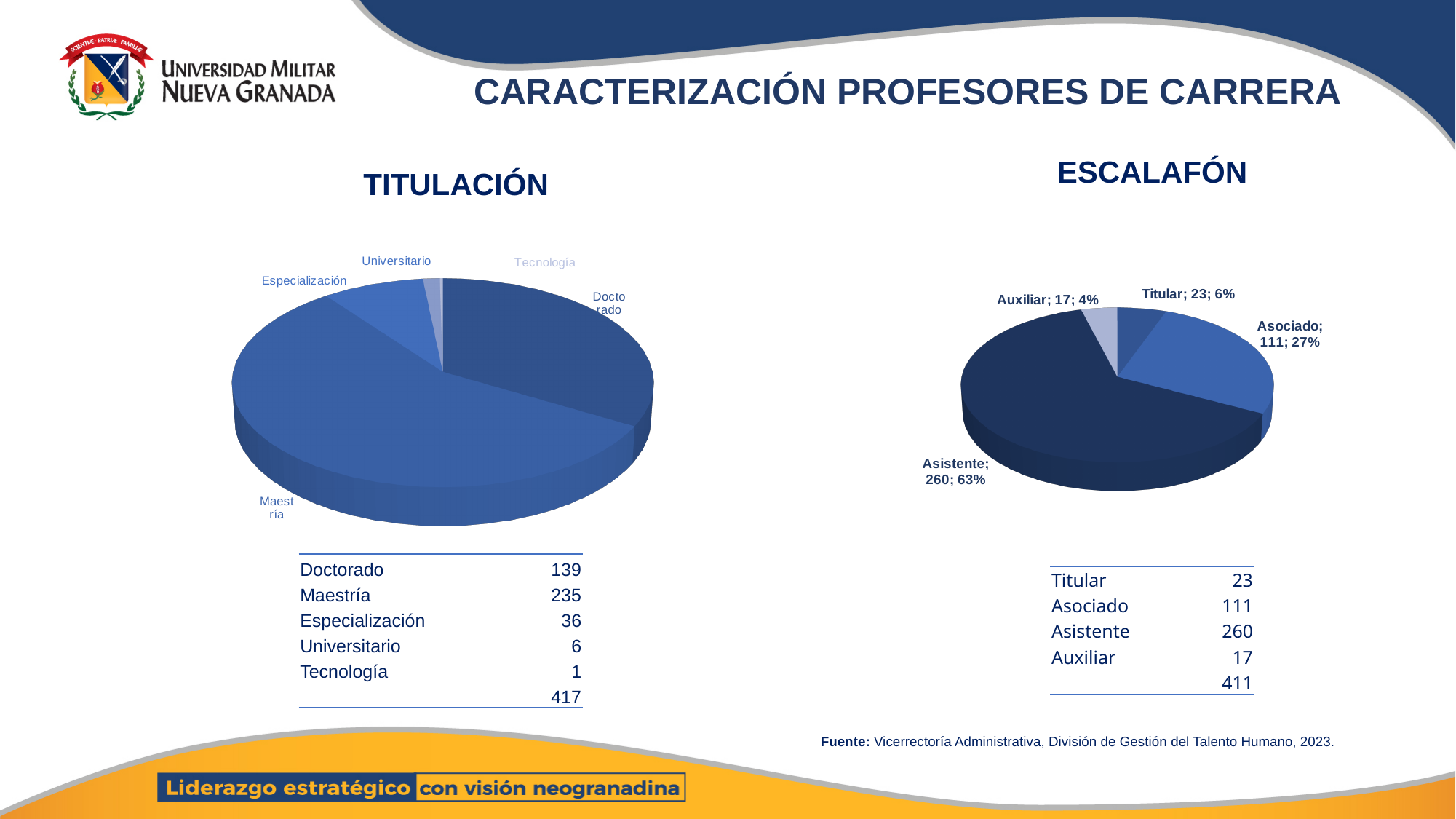
In the ESCALAFÓN chart, which is larger, Titular or Auxiliar? Titular In the TITULACIÓN chart, which category has the largest slice? Maestría What kind of chart is the TITULACIÓN chart? pie chart In the ESCALAFÓN chart, what is the difference between Asistente and Asociado? 149 In the TITULACIÓN chart, how many professors have a Maestría? 235 In the ESCALAFÓN chart, what share of the pie does Asistente represent? 63% In the TITULACIÓN chart, what is the difference between Maestría and Doctorado? 96 How many categories does the TITULACIÓN pie chart have? 5 In the ESCALAFÓN chart, what value is shown for Asociado? 111 What is the total of all categories in the TITULACIÓN chart? 417 How many categories does the ESCALAFÓN pie chart have? 4 In the TITULACIÓN chart, which category has the smallest slice? Tecnología